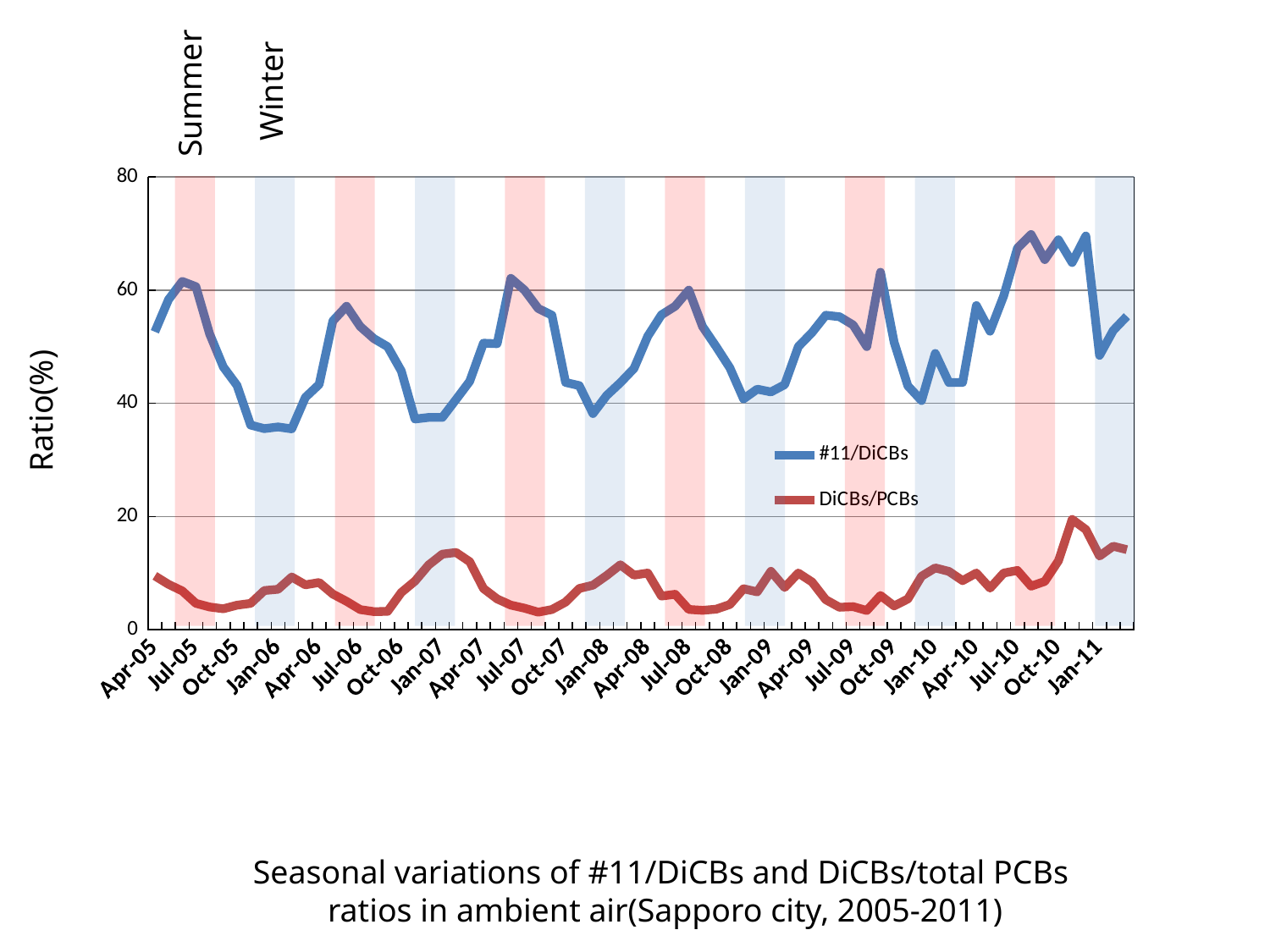
How many series does the legend list? 2 Is the value of #11/DiCBs at Jan-06 greater or less than 40? less At Jan-06, which series has the higher value, #11/DiCBs or DiCBs/PCBs? #11/DiCBs Is the value of DiCBs/PCBs at Jan-11 greater or less than 20? less Is the value of #11/DiCBs at Jul-07 greater or less than 40? greater What is the label on the y axis? Ratio(%) Does the #11/DiCBs series rise or fall between Jan-06 and Jul-06? Rise Which series is drawn in red? DiCBs/PCBs Does the #11/DiCBs series rise or fall between Jul-05 and Jan-06? Fall How many date labels are shown on the x axis? 24 What kind of chart is shown on the slide? Line chart